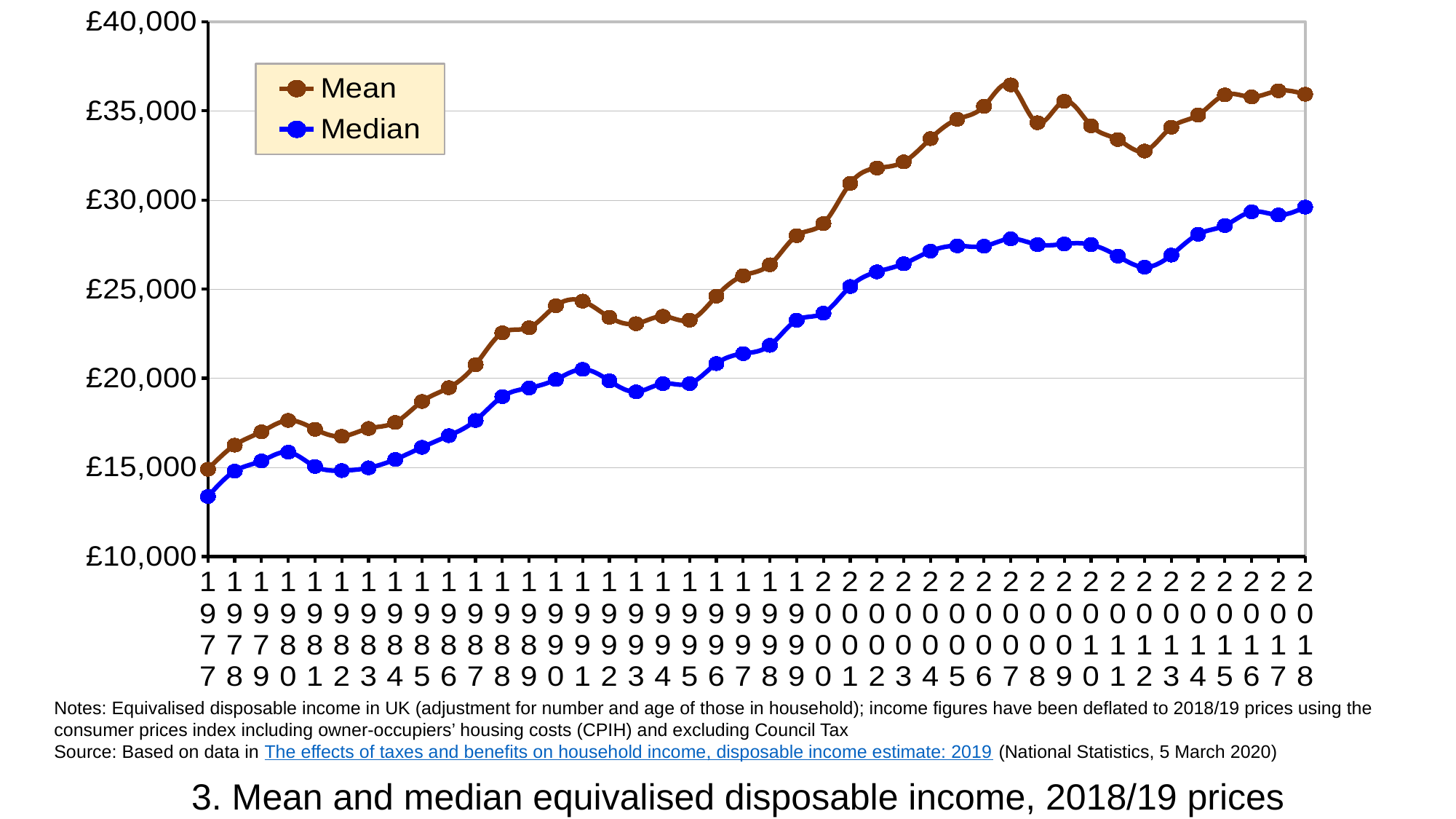
How many series does the legend list? 2 Is the Median value for 1977 greater or less than £15,000? less In which year does the Mean series reach its highest value? 2007 What is the title of the chart? 3. Mean and median equivalised disposable income, 2018/19 prices Is the Median value for 2018 greater or less than £30,000? less Is the Mean value for 2007 greater or less than £35,000? greater What type of chart is shown on the slide? Line chart Which two series are plotted on the chart? Mean and Median In which year is the Median series at its lowest value? 1977 How many years are plotted along the x axis? 42 In 2018, which series has the larger value, Mean or Median? Mean Overall, do the Mean and Median values rise or fall from 1977 to 2018? rise